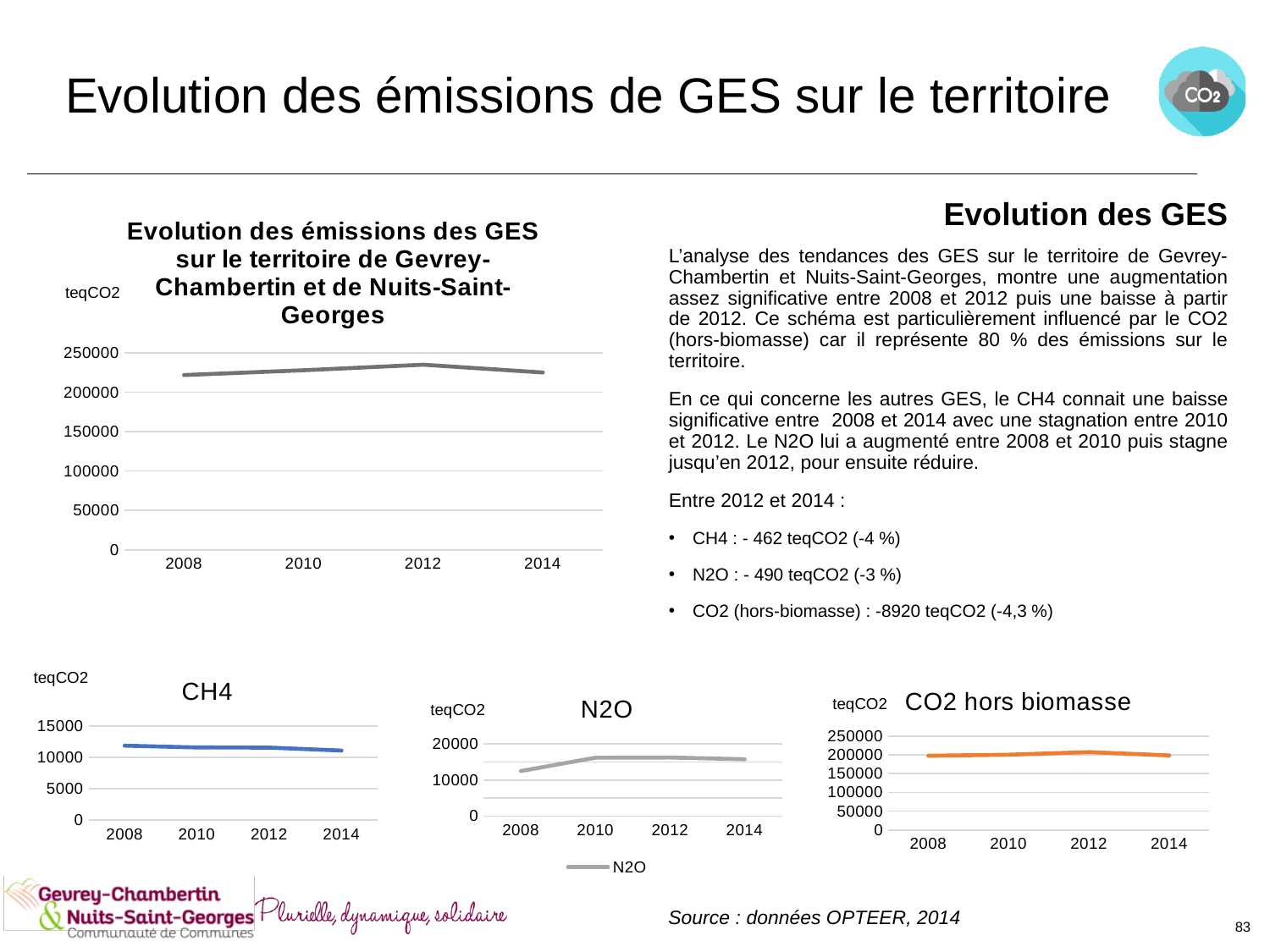
In the 'Evolution des émissions des GES sur le territoire de Gevrey-Chambertin et de Nuits-Saint-Georges' chart, is the value for 2008 greater or less than 200000? greater How many series does the legend of the 'N2O' chart list? 1 What unit label is shown above the y axis of the 'CO2 hors biomasse' chart? teqCO2 What kind of chart is the 'CH4' chart at the bottom left of the slide? line chart In the 'N2O' chart, is the value for 2010 greater or less than 20000? less In the 'CH4' chart, is the value for 2014 greater or less than 10000? greater How many years are plotted on the x axis of the 'Evolution des émissions des GES sur le territoire de Gevrey-Chambertin et de Nuits-Saint-Georges' chart? 4 In the 'N2O' chart, which year has the lowest value? 2008 In the 'CH4' chart, do the values rise or fall from 2008 to 2014? fall In the 'Evolution des émissions des GES sur le territoire de Gevrey-Chambertin et de Nuits-Saint-Georges' chart, which year has the highest value? 2012